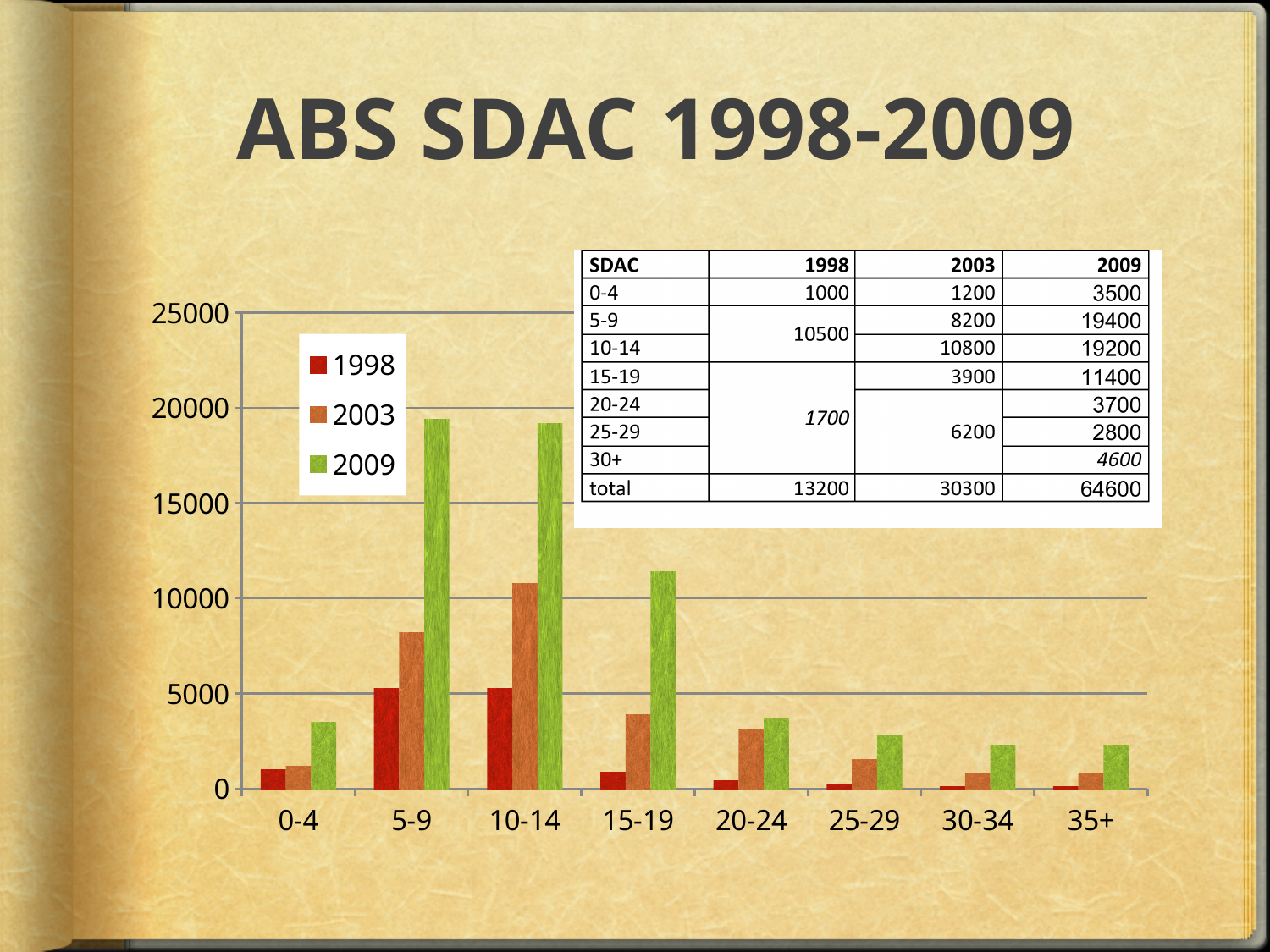
What is the title of the slide containing the chart? ABS SDAC 1998-2009 What is the 2009 value for the 15-19 age group? 11400 What is the 2003 value for the 10-14 age group? 10800 Do the 2009 values rise or fall along the x axis from 10-14 to 25-29? fall Is the 2003 value for the 15-19 age group greater or less than 5000? less Is the 1998 value for the 5-9 age group greater or less than 5000? greater How many age categories are shown along the x axis of the chart? 8 For the 20-24 age group, which series has the larger value, 2003 or 2009? 2009 What is the 2009 value for the 0-4 age group? 3500 What kind of chart is shown on the slide? bar chart How many series does the chart's legend list? 3 What is the difference between the 2009 and 2003 values for the 5-9 age group? 11200